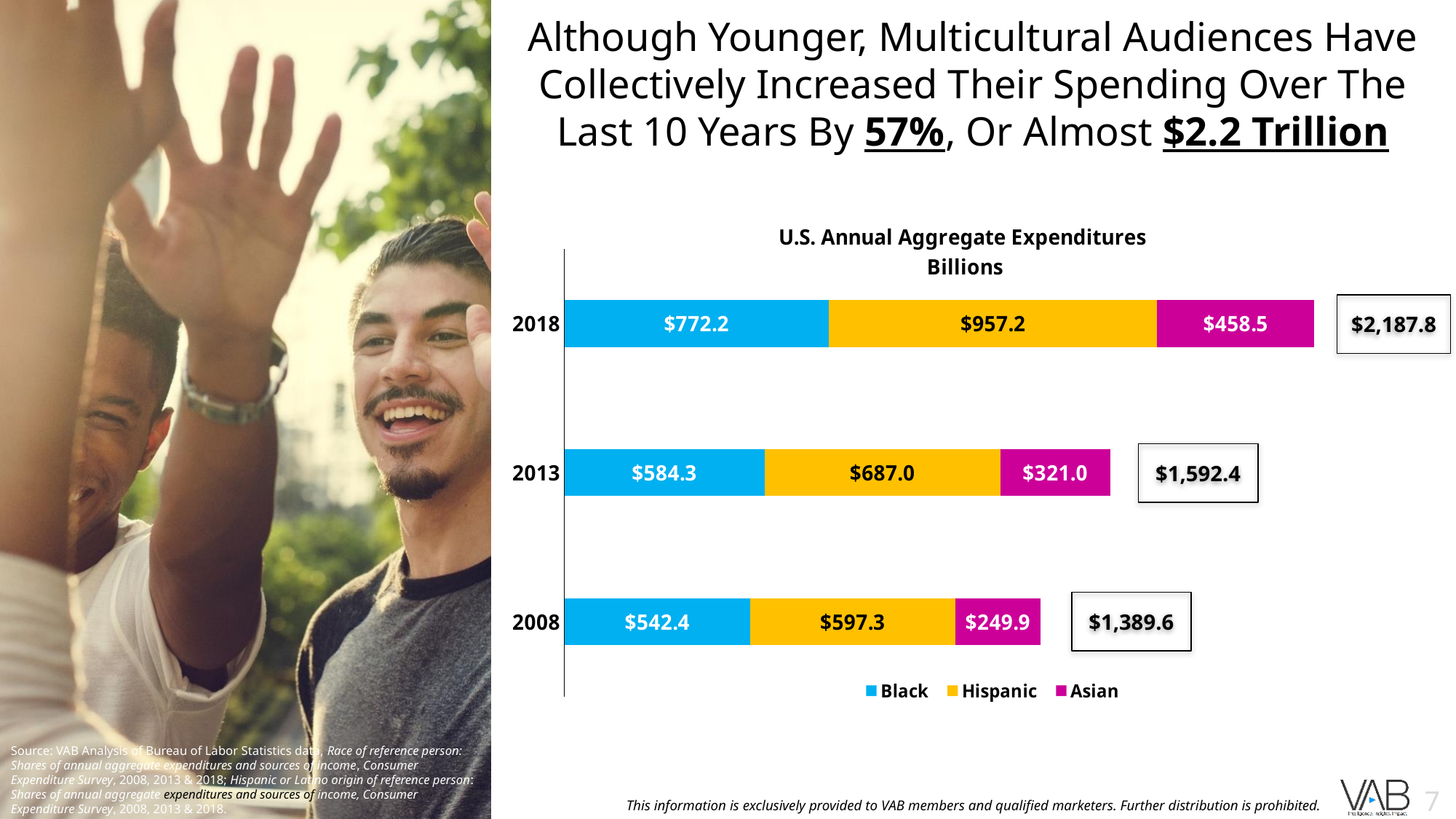
What is the Asian expenditure value for 2008? $249.9 What kind of chart is shown on the slide? Stacked bar chart What is the title of the chart? U.S. Annual Aggregate Expenditures Billions What is the Black expenditure value for 2013? $584.3 How many series does the legend list? 3 What is the total aggregate expenditure shown for 2008? $1,389.6 What is the Hispanic expenditure value for 2018? $957.2 What is the difference between the Hispanic values for 2018 and 2008? $359.9 What is the total aggregate expenditure shown for 2018? $2,187.8 Which is larger, the Black value in 2018 or the Hispanic value in 2013? Black value in 2018 Which series has the lowest value in 2013? Asian Which year has the highest total aggregate expenditure? 2018